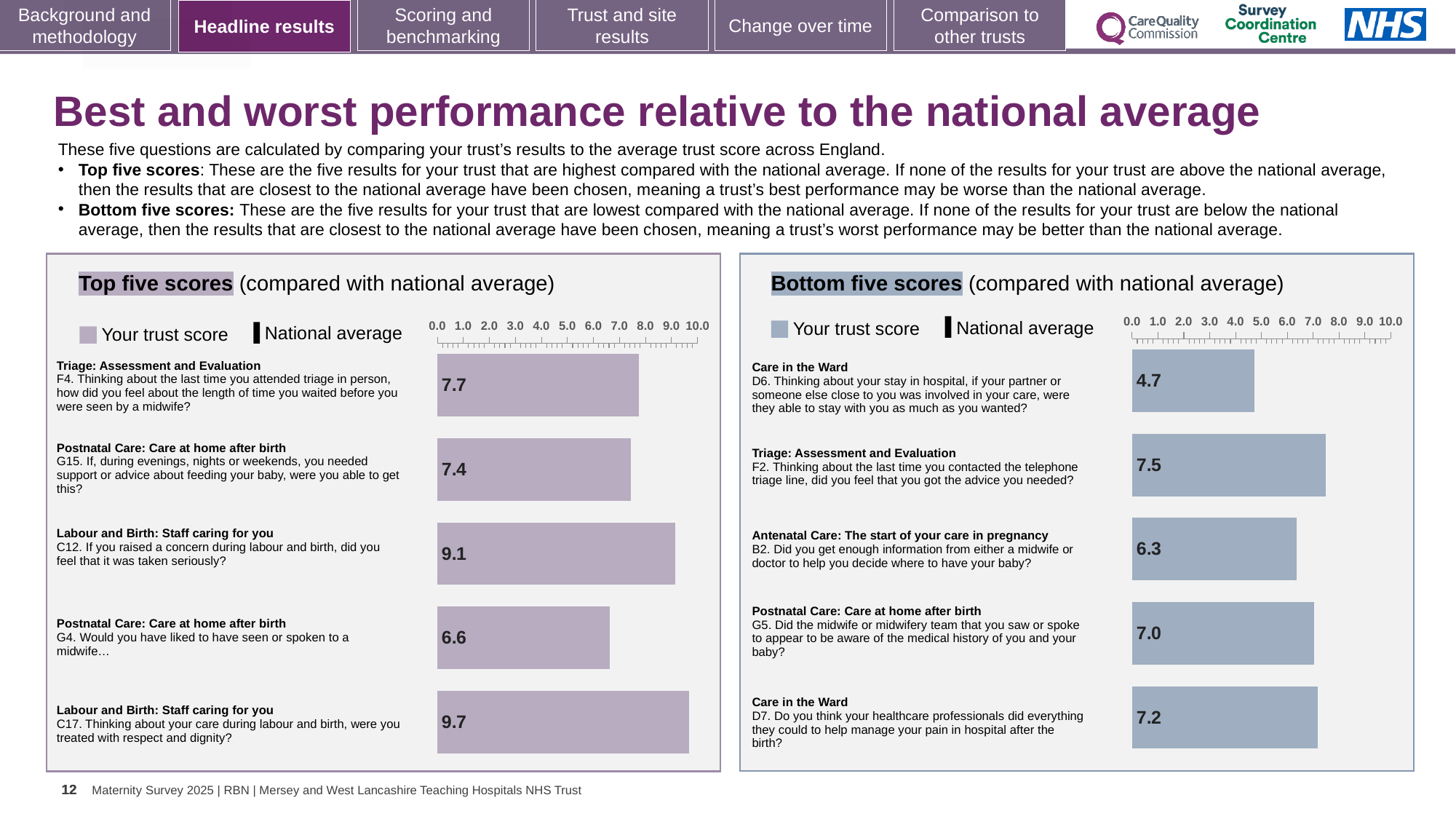
In the 'Top five scores' chart, which question has the highest trust score? C17 (Labour and Birth: Staff caring for you), 9.7 In the 'Top five scores' chart, what is the trust score for question C12 (If you raised a concern during labour and birth, did you feel that it was taken seriously?)? 9.1 In the 'Top five scores' chart, what is the difference between the trust scores for C17 and G4? 3.1 What kind of chart is the 'Top five scores' chart? Bar chart In the 'Bottom five scores' chart, what is the trust score for question D6 (Care in the Ward, partner able to stay with you)? 4.7 In the 'Bottom five scores' chart, which has the larger trust score: F2 (telephone triage line) or D7 (pain management after birth)? F2, 7.5 In the 'Bottom five scores' chart, what is the difference between the trust scores for F2 and B2? 1.2 How many series does the legend of the 'Top five scores' chart list? 2 How many bars are plotted in the 'Bottom five scores' chart? 5 In the 'Top five scores' chart, is the trust score for G15 greater or less than 7.0? greater In the 'Top five scores' chart, which question has the lowest trust score? G4 (Postnatal Care: Care at home after birth), 6.6 In the 'Bottom five scores' chart, which question has the lowest trust score? D6 (Care in the Ward), 4.7